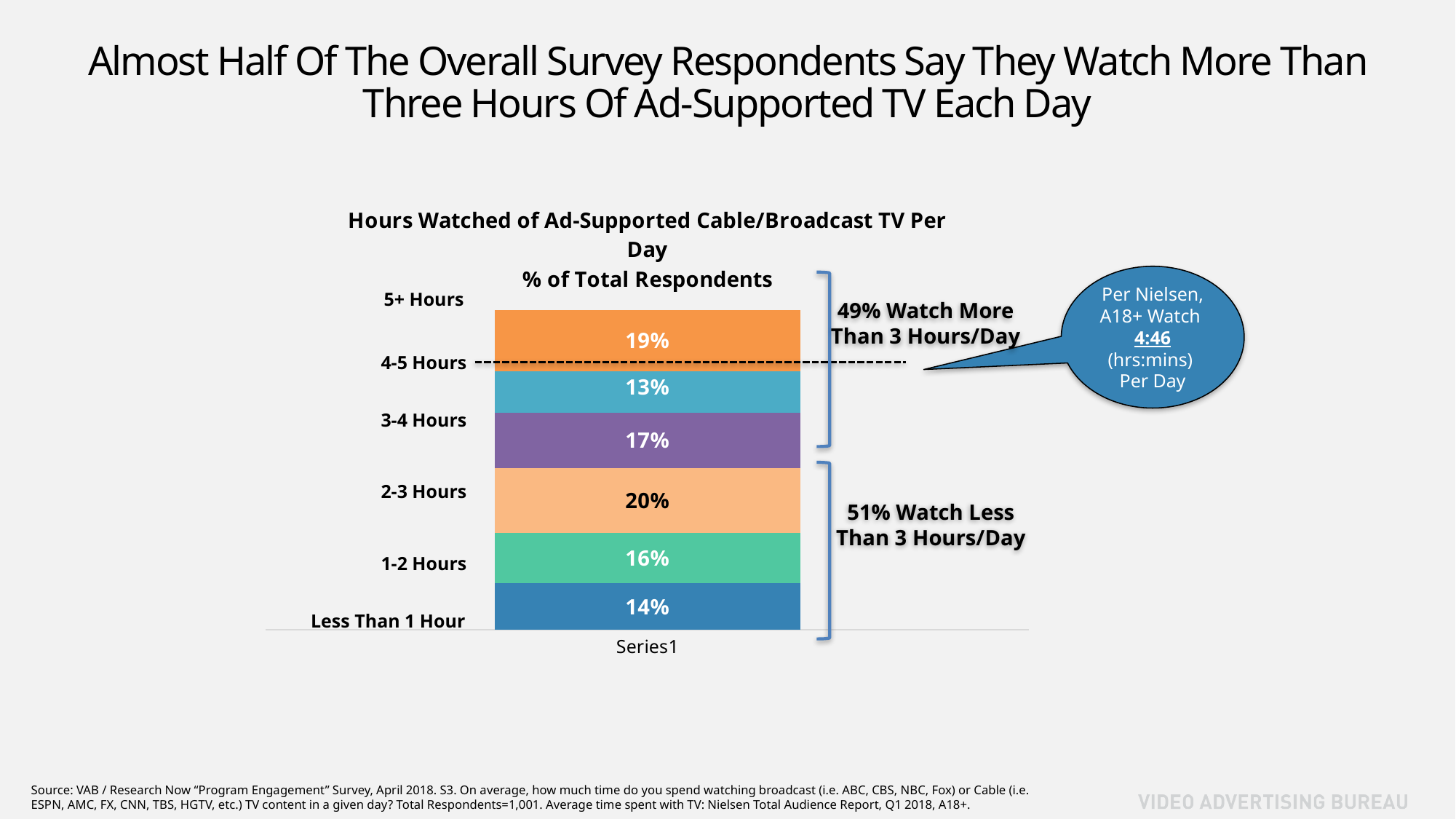
What is the title of the chart? Hours Watched of Ad-Supported Cable/Broadcast TV Per Day % of Total Respondents What percentage of respondents watch less than 1 hour per day? 14% Which hours-watched category has the smallest share of respondents? 4-5 Hours Which hours-watched category has the largest share of respondents? 2-3 Hours How many hours-watched categories are shown in the stacked bar? 6 What percentage of respondents watch 4-5 hours per day? 13% What is the difference between the share of respondents watching 2-3 hours and those watching 4-5 hours? 7% What percentage of respondents watch 2-3 hours of ad-supported TV per day? 20% What type of chart is shown on the slide? Stacked bar chart What percentage of respondents watch 5+ hours per day? 19% Which is larger: the share watching 3-4 hours or the share watching 1-2 hours? 3-4 Hours According to the annotation, what percentage of respondents watch more than 3 hours per day? 49%